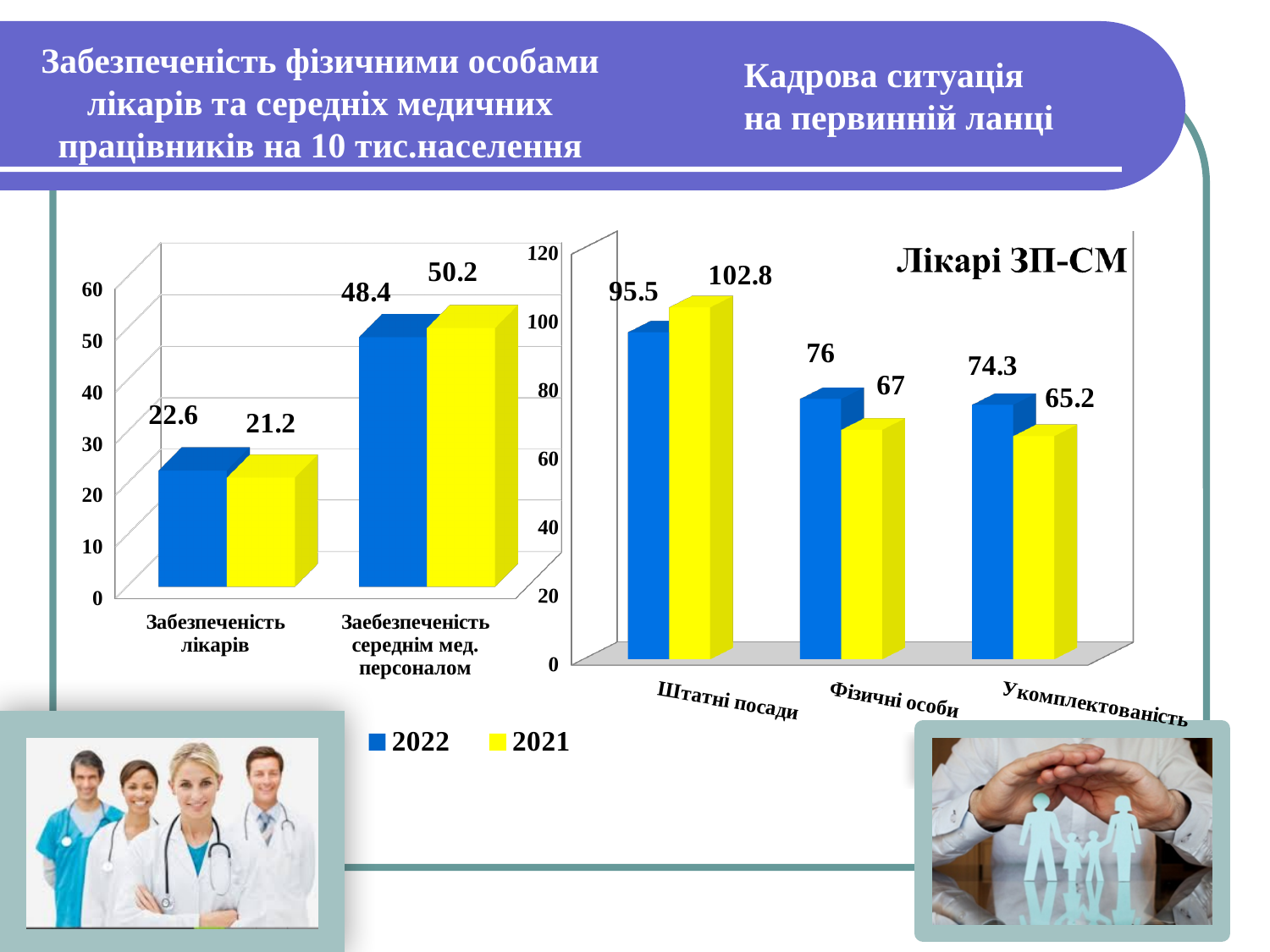
What type of chart is the chart titled Лікарі ЗП-СМ? Bar chart In the chart titled Лікарі ЗП-СМ, what is the 2021 value for Штатні посади? 102.8 In the left chart, what is the 2022 value for Забезпеченість лікарів? 22.6 In the left chart, which year has the larger value for Забезпеченість лікарів, 2022 or 2021? 2022 In the left chart, what is the difference between the 2021 and 2022 values for Заебезпеченість середнім мед. персоналом? 1.8 In the chart titled Лікарі ЗП-СМ, which category has the lowest 2021 value? Укомплектованість In the chart titled Лікарі ЗП-СМ, what is the difference between the 2022 and 2021 values for Фізичні особи? 9 How many series does the legend list? 2 In the left chart, what is the 2021 value for Заебезпеченість середнім мед. персоналом? 50.2 In the chart titled Лікарі ЗП-СМ, what is the 2022 value for Укомплектованість? 74.3 How many categories are shown in the chart titled Лікарі ЗП-СМ? 3 In the chart titled Лікарі ЗП-СМ, which category has the highest 2022 value? Штатні посади